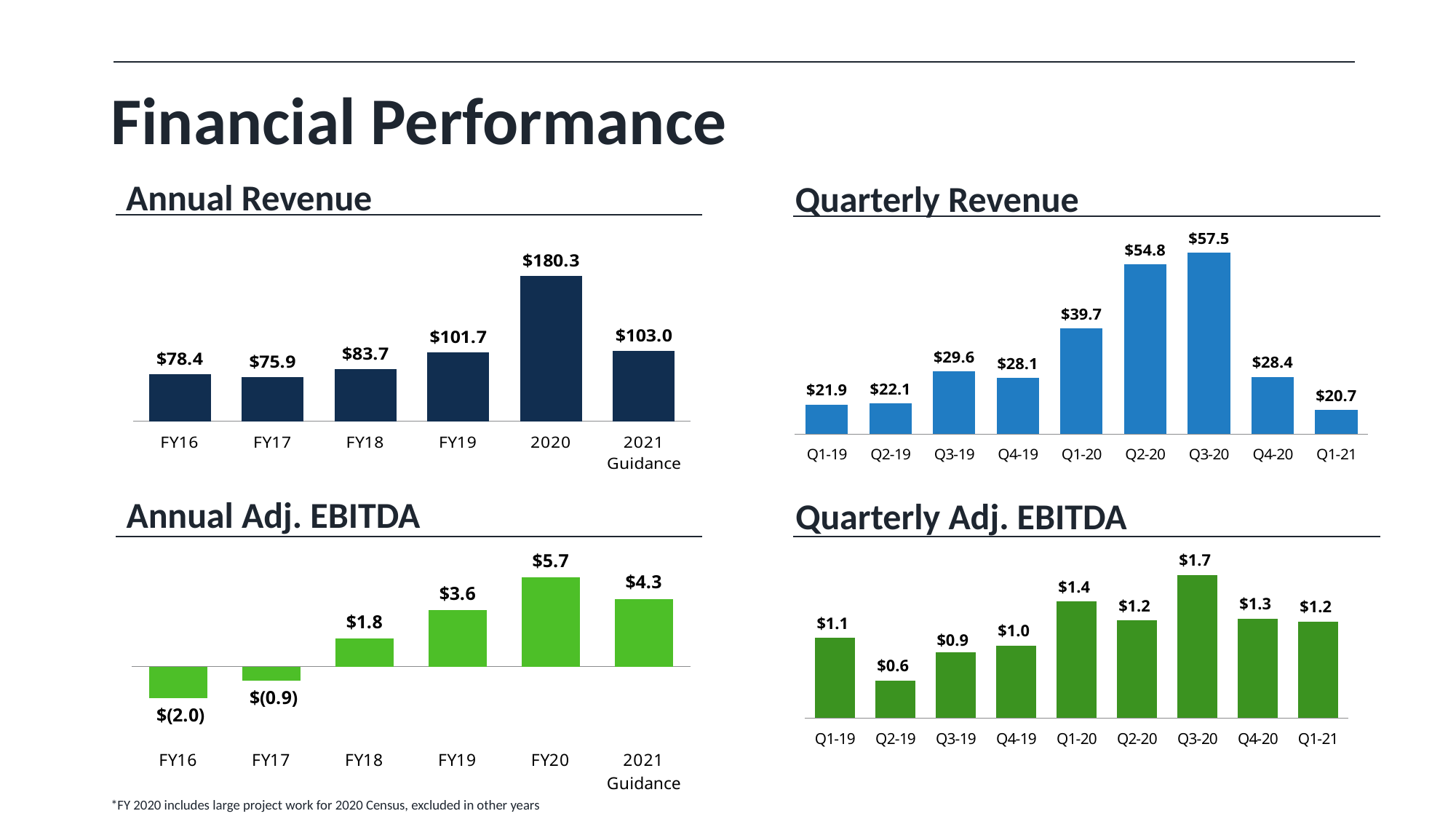
In the Annual Revenue chart, which category has the lowest value? FY17 In the Quarterly Revenue chart, how many quarters are shown? 9 In the Quarterly Revenue chart, which is larger, Q4-19 or Q4-20? Q4-20 In the Annual Adj. EBITDA chart, what is the difference between FY19 and FY18? $1.8 In the Annual Revenue chart, what is the difference between the 2020 value and the 2021 Guidance value? $77.3 In the Quarterly Revenue chart, which quarter has the highest value? Q3-20 In the Annual Adj. EBITDA chart, which category has the highest value? FY20 In the Annual Adj. EBITDA chart, what is the value for FY16? $(2.0) In the Annual Revenue chart, what is the value for 2020? $180.3 What kind of chart is the Quarterly Adj. EBITDA chart? Bar chart In the Quarterly Adj. EBITDA chart, which quarter has the lowest value? Q2-19 In the Quarterly Revenue chart, what is the value for Q1-20? $39.7